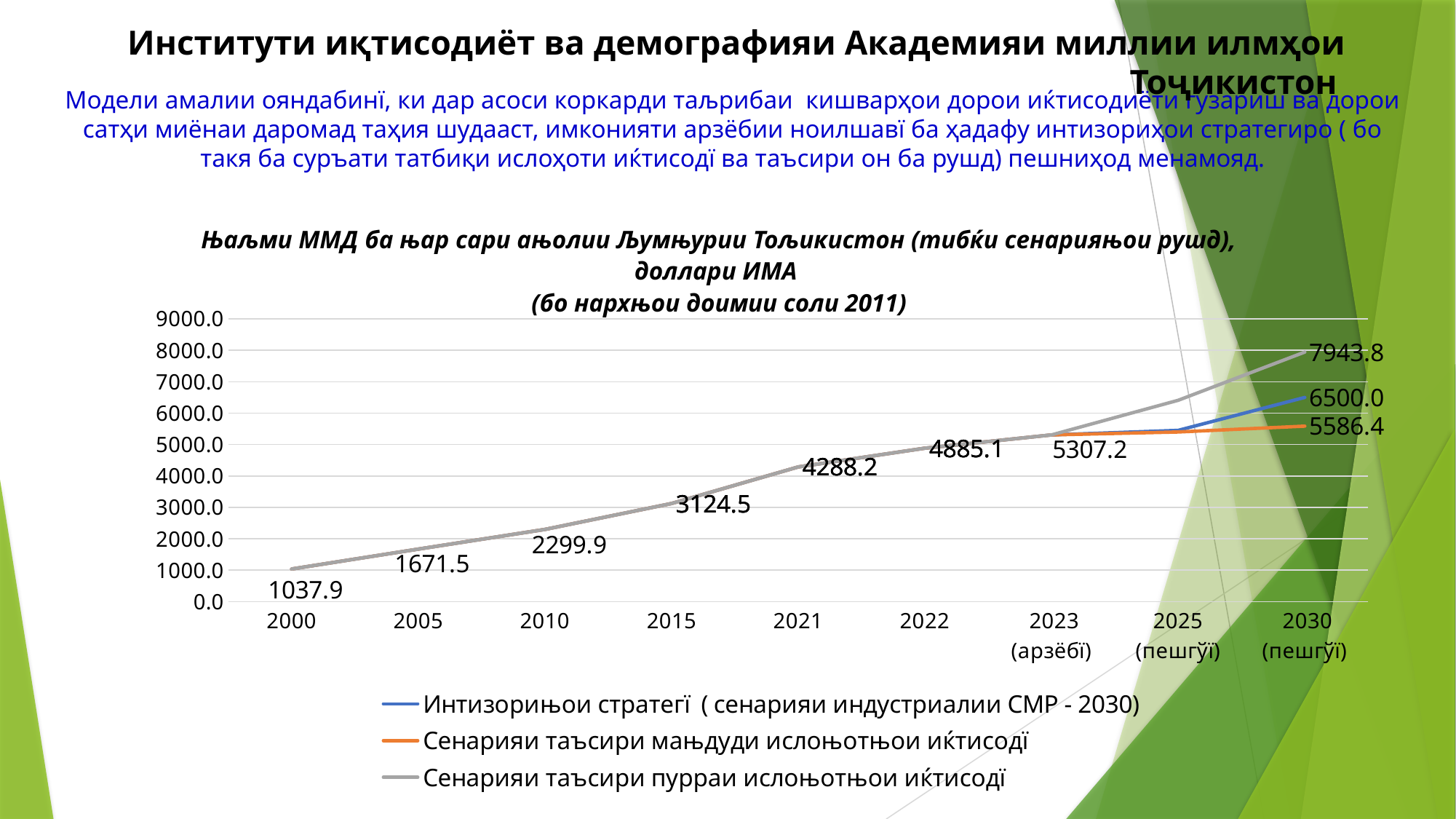
What is the value plotted for 2015? 3124.5 What is the 2030 value for the series 'Сенарияи таъсири мањдуди ислоњотњои иќтисодї' (orange line)? 5586.4 What kind of chart is shown on the slide? line chart What is the 2030 value for the series 'Интизорињои стратегї ( сенарияи индустриалии СМР - 2030)' (blue line)? 6500.0 What is the 2030 value for the series 'Сенарияи таъсири пурраи ислоњотњои иќтисодї' (gray line)? 7943.8 Do the plotted values rise or fall from 2000 to 2030? rise What is the value plotted for 2000? 1037.9 How many year categories are shown on the x axis? 9 Which series has the highest value in 2030? Сенарияи таъсири пурраи ислоњотњои иќтисодї What is the value for 2023 (арзёбӣ)? 5307.2 What is the difference between the gray line's 2030 value and the orange line's 2030 value? 2357.4 How many series does the legend list? 3